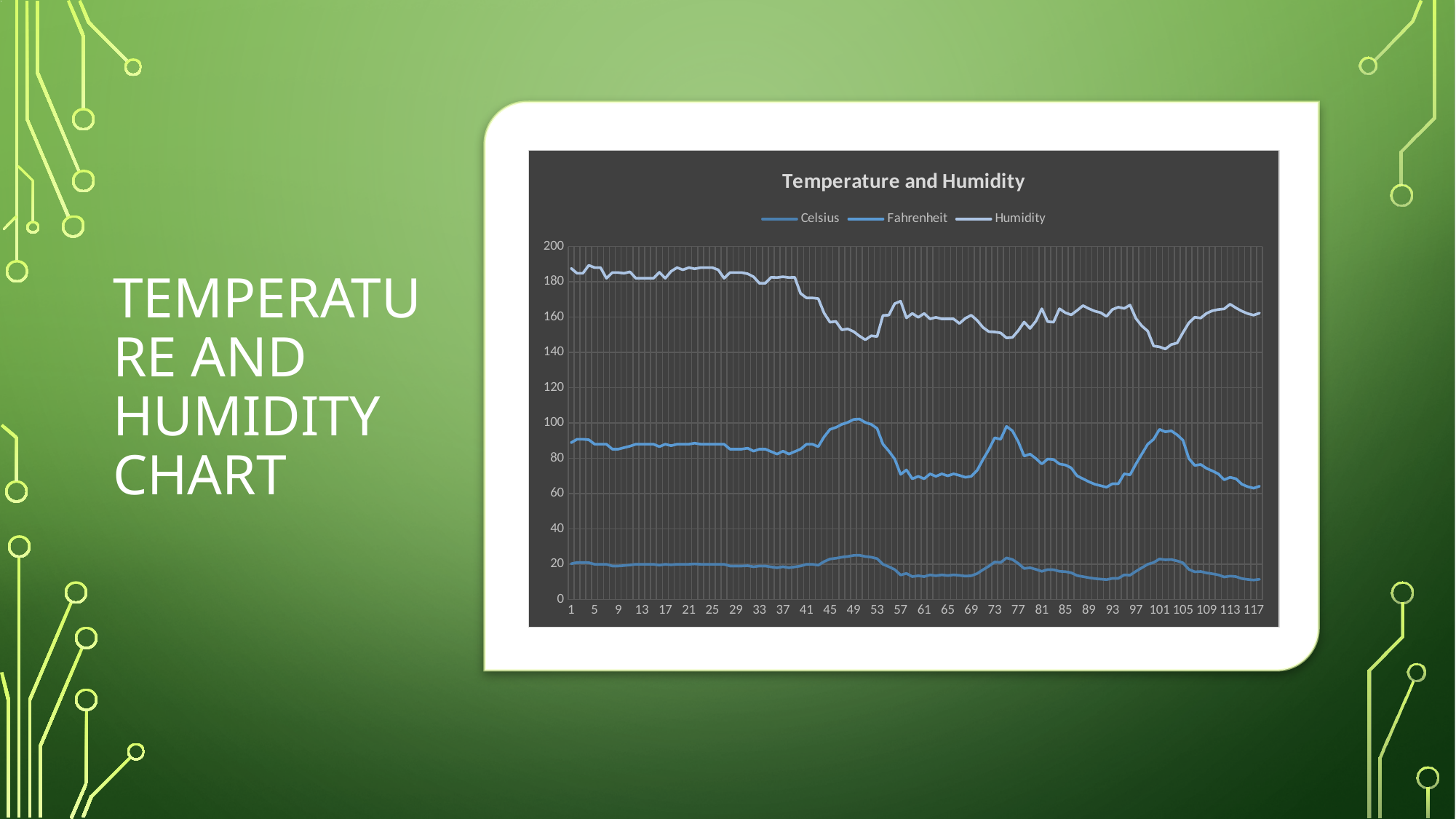
At point 1, which series has the larger value, Fahrenheit or Celsius? Fahrenheit Which series are listed in the chart's legend? Celsius, Fahrenheit, Humidity Is the Humidity value at point 101 greater or less than 160? less How many series does the legend of the chart list? 3 What kind of chart is shown on the slide? line chart Is the Celsius value at point 117 greater or less than 20? less Which series has the lowest values throughout the chart? Celsius Which series has the highest values throughout the chart? Humidity Does the Humidity series end higher or lower at point 117 than it starts at point 1? lower Is the Fahrenheit value at point 61 greater or less than 80? less What is the title of the chart? Temperature and Humidity